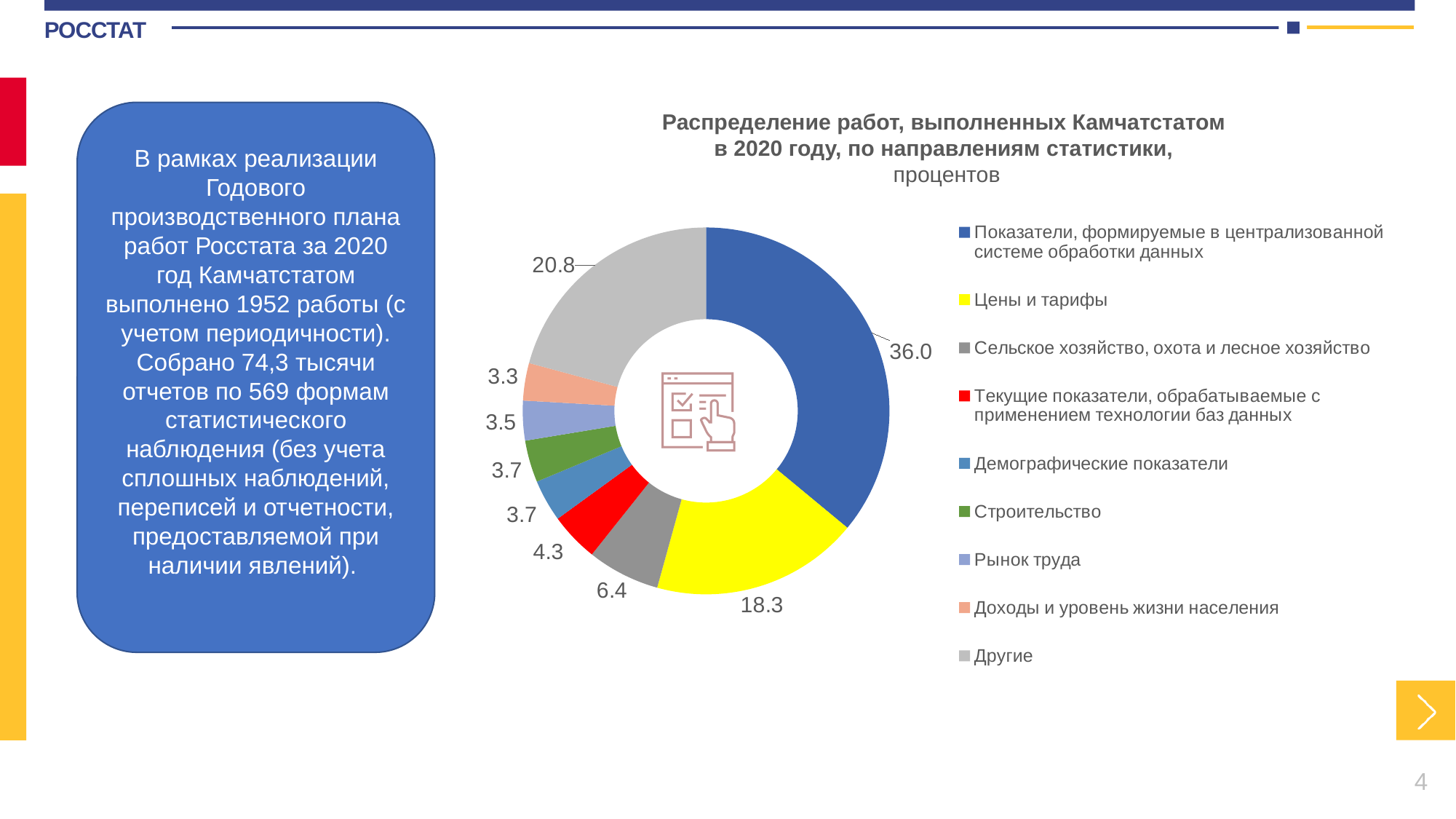
What share of the work is attributed to "Цены и тарифы"? 18.3 Which category has the smallest share of the chart? Доходы и уровень жизни населения What kind of chart is shown on the slide? Doughnut (pie) chart What value is shown for "Сельское хозяйство, охота и лесное хозяйство"? 6.4 What is the difference between the values for "Показатели, формируемые в централизованной системе обработки данных" and "Цены и тарифы"? 17.7 What value is shown for "Другие"? 20.8 How many categories are shown in the chart? 9 What is the difference between the values for "Текущие показатели, обрабатываемые с применением технологии баз данных" and "Рынок труда"? 0.8 Which category has the largest share of the chart? Показатели, формируемые в централизованной системе обработки данных What colour represents "Строительство" in the chart? Green What value is shown for "Доходы и уровень жизни населения"? 3.3 Which is larger: the value for "Другие" or the value for "Цены и тарифы"? Другие